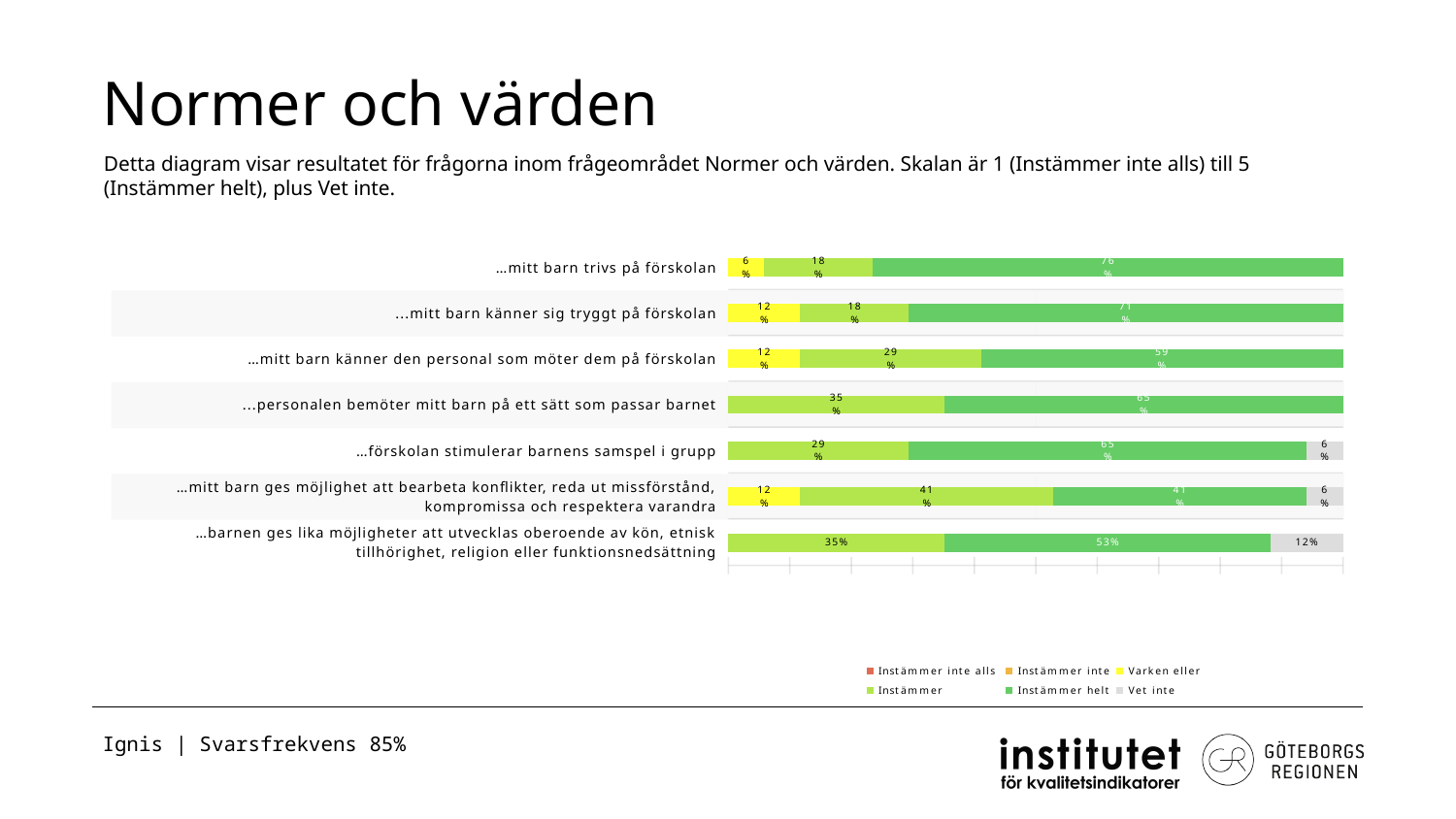
Which statement has the lowest 'Instämmer helt' value? …mitt barn ges möjlighet att bearbeta konflikter, reda ut missförstånd, kompromissa och respektera varandra What is the 'Vet inte' value for '…barnen ges lika möjligheter att utvecklas oberoende av kön, etnisk tillhörighet, religion eller funktionsnedsättning'? 12% What kind of chart is shown on the slide? Stacked bar chart What is the difference between the 'Instämmer helt' values for '…mitt barn trivs på förskolan' and '…mitt barn känner den personal som möter dem på förskolan'? 17 percentage points What is the 'Instämmer helt' value for '…mitt barn trivs på förskolan'? 76% How many statements (categories) are shown in the chart? 7 What is the title of the slide containing the chart? Normer och värden What is the 'Instämmer' value for '…personalen bemöter mitt barn på ett sätt som passar barnet'? 35% How many series does the legend list? 6 Which is larger: the 'Instämmer' value for '…mitt barn känner den personal som möter dem på förskolan' or for '…mitt barn känner sig tryggt på förskolan'? …mitt barn känner den personal som möter dem på förskolan What is the 'Instämmer helt' value for '…mitt barn känner sig tryggt på förskolan'? 71% Which statement has the highest 'Instämmer helt' value? …mitt barn trivs på förskolan